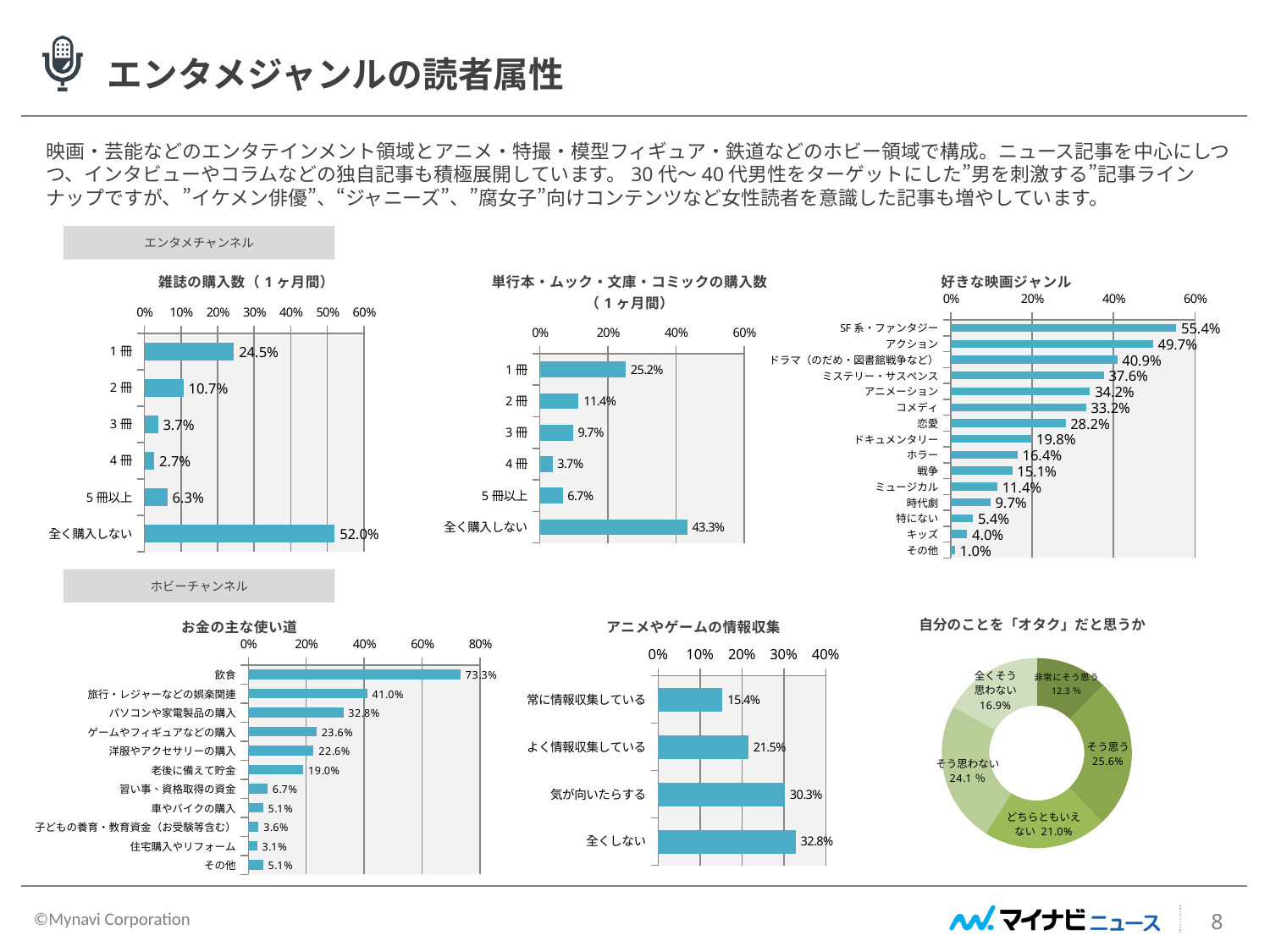
In the 雑誌の購入数（1ヶ月間） chart, what is the value for 全く購入しない? 52.0% In the 単行本・ムック・文庫・コミックの購入数（1ヶ月間） chart, what is the difference between 全く購入しない and 1冊? 18.1% In the アニメやゲームの情報収集 chart, what is the value for 気が向いたらする? 30.3% In the お金の主な使い道 chart, which is larger, ゲームやフィギュアなどの購入 or 老後に備えて貯金? ゲームやフィギュアなどの購入 What kind of chart is the 自分のことを「オタク」だと思うか chart? Donut (pie) chart In the 好きな映画ジャンル chart, what is the value for ホラー? 16.4% In the お金の主な使い道 chart, what is the value for 飲食? 73.3% In the 単行本・ムック・文庫・コミックの購入数（1ヶ月間） chart, what is the value for 1冊? 25.2% In the 好きな映画ジャンル chart, which genre has the highest value? SF系・ファンタジー In the 雑誌の購入数（1ヶ月間） chart, which category has the lowest value? 4冊 In the 自分のことを「オタク」だと思うか chart, what share is そう思う? 25.6% In the 好きな映画ジャンル chart, how many categories are plotted? 15